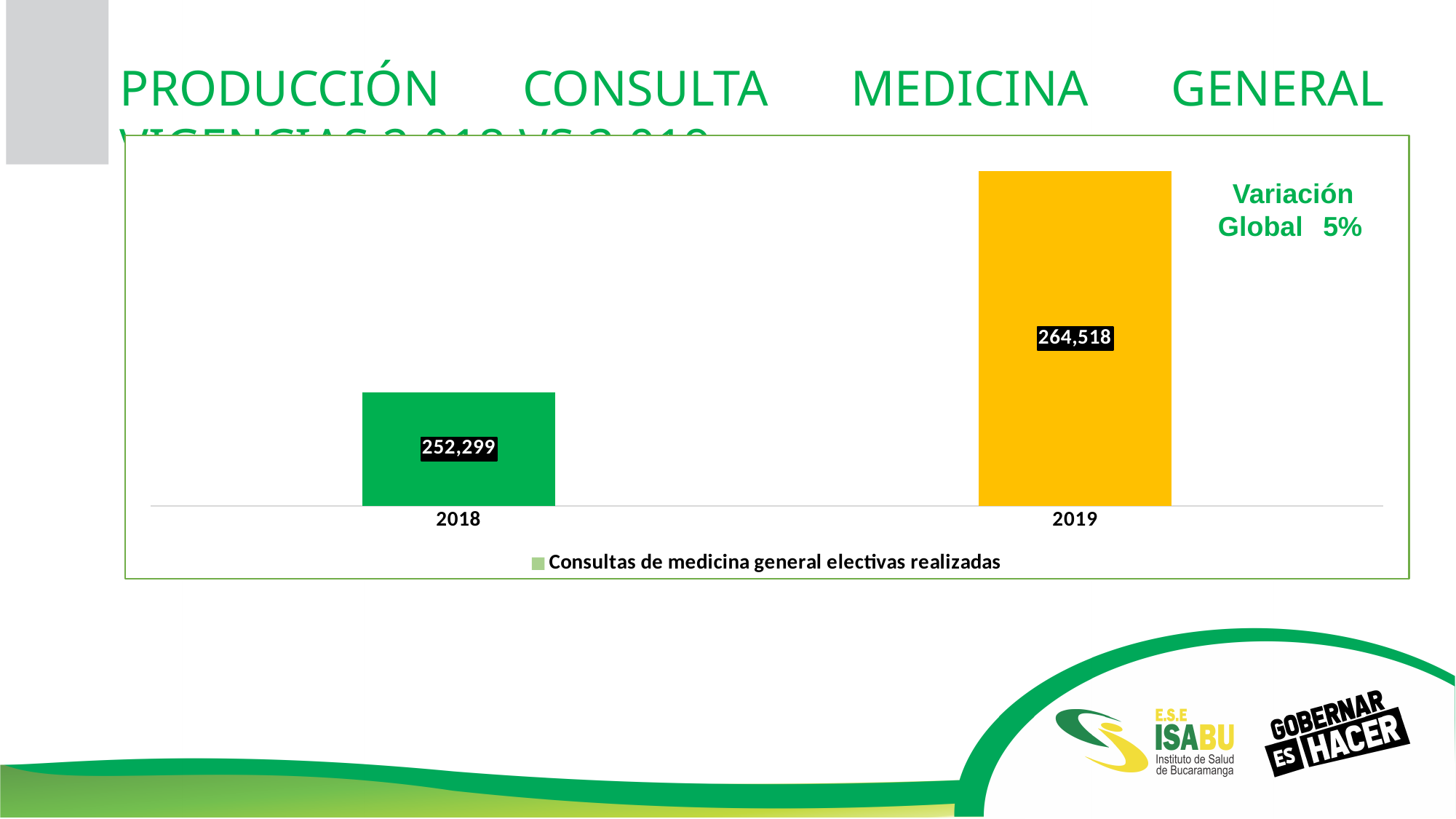
What series name does the legend show? Consultas de medicina general electivas realizadas What is the value for 2018? 252,299 What is the value for 2019? 264,518 What global variation percentage is printed on the chart? 5% How many series does the legend list? 1 Is the value for 2019 larger or smaller than the value for 2018? larger How many categories are shown on the x axis? 2 Do the values rise or fall from 2018 to 2019? rise Which year has the higher value? 2019 What is the difference between the 2019 and 2018 values? 12,219 What kind of chart is shown? bar chart Which year has the lower value? 2018